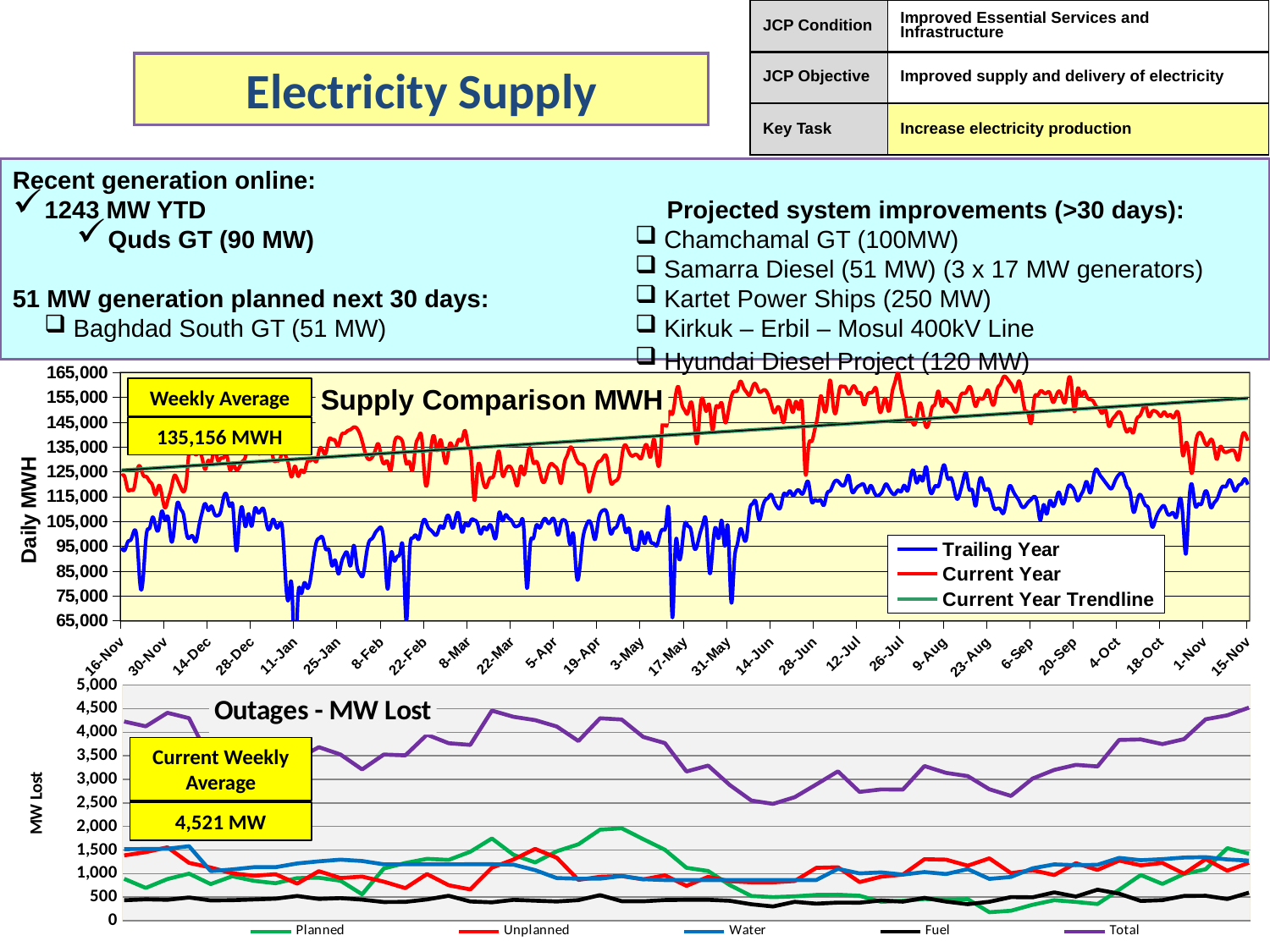
In the Supply Comparison MWH chart, which series is higher around 14-Jun, Current Year or Trailing Year? Current Year What kind of chart is the Outages - MW Lost chart? line chart In the Supply Comparison MWH chart, what is the label on the vertical axis? Daily MWH In the Supply Comparison MWH chart, does the Current Year Trendline rise or fall from left to right? rise How many series does the legend of the Outages - MW Lost chart list? 5 In the Supply Comparison MWH chart, is the Current Year value around 14-Jun greater or less than 145,000? greater In the Outages - MW Lost chart, which series has the highest values across the chart? Total In the Outages - MW Lost chart, what current weekly average value is shown in the yellow box? 4,521 MW In the Outages - MW Lost chart, is the Total value at the far left of the chart greater or less than 4,000? greater How many series does the legend of the Supply Comparison MWH chart list? 3 What kind of chart is the Supply Comparison MWH chart? line chart In the Supply Comparison MWH chart, what weekly average value is shown in the yellow box? 135,156 MWH